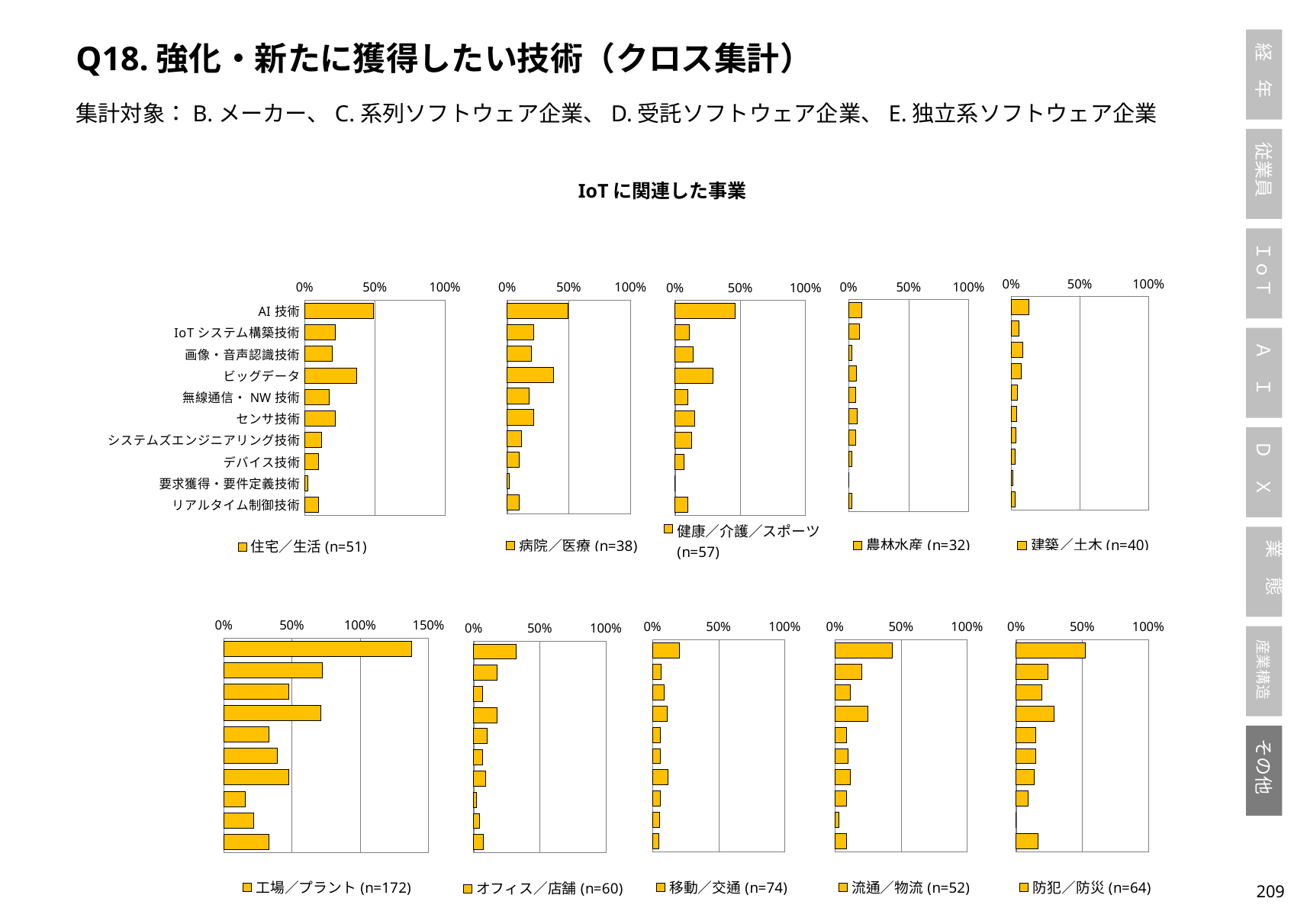
In the 住宅／生活 (n=51) chart, which technology has the lowest value? 要求獲得・要件定義技術 In the 住宅／生活 (n=51) chart, which is larger, the value for AI 技術 or the value for ビッグデータ? AI 技術 How many series does the legend of the 工場／プラント (n=172) chart list? 1 In the 病院／医療 (n=38) chart, is the value for ビッグデータ greater or less than 50%? less In the 住宅／生活 (n=51) chart, which technology has the highest value? AI 技術 In the 工場／プラント (n=172) chart, is the value for IoT システム構築技術 greater or less than 50%? greater In the 流通／物流 (n=52) chart, which is larger, the value for AI 技術 or the value for ビッグデータ? AI 技術 How many separate bar charts are shown on the slide? 10 What is the common title shown above the group of charts? IoT に関連した事業 How many technology categories are listed on the y axis of the 住宅／生活 (n=51) chart? 10 What kind of chart is used for the 住宅／生活 (n=51) panel? bar chart In the 工場／プラント (n=172) chart, is the value for AI 技術 greater or less than 100%? greater